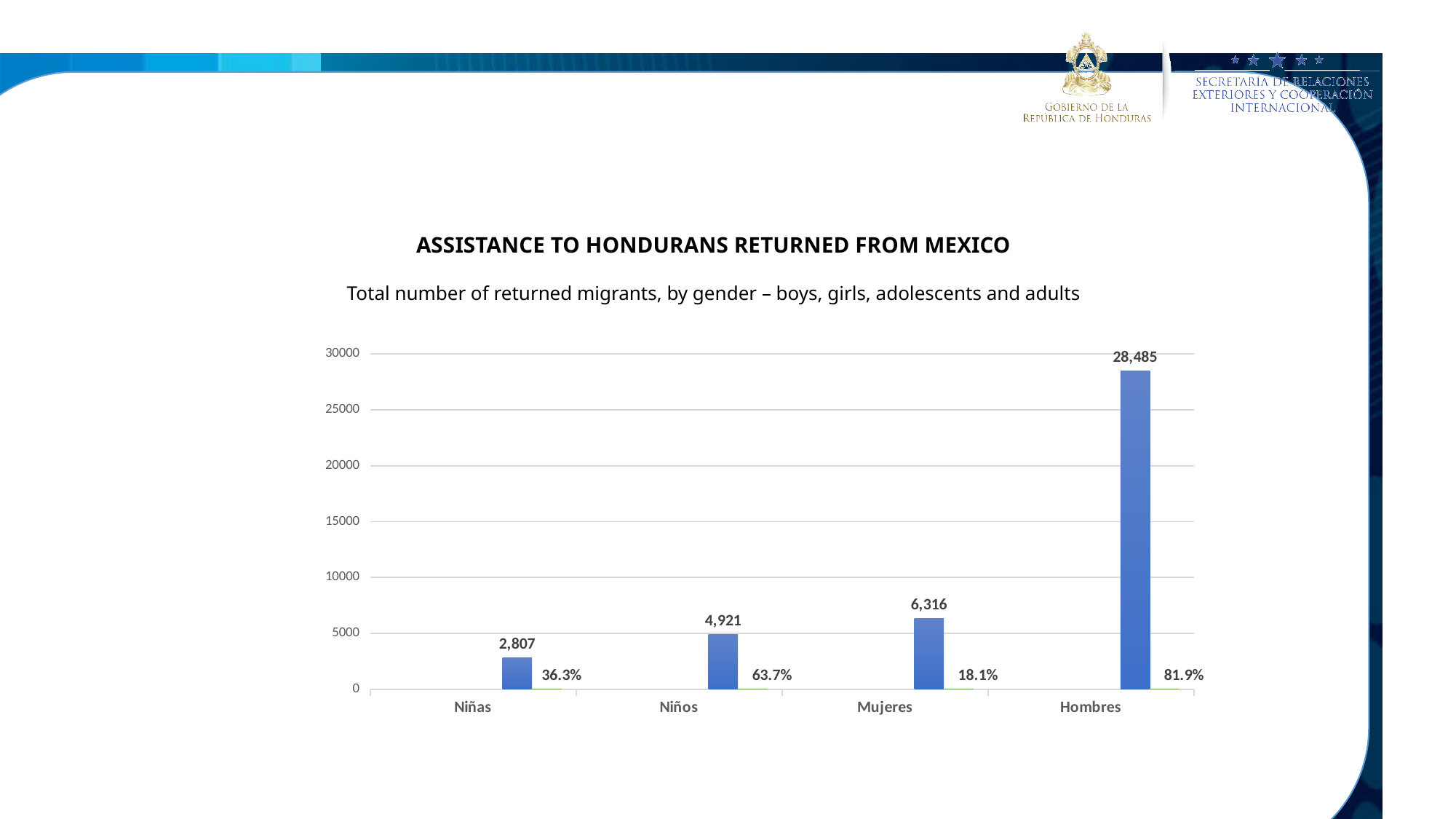
What is the title of the chart? ASSISTANCE TO HONDURANS RETURNED FROM MEXICO What is the number of returned migrants for Niñas? 2,807 Which category has the highest number of returned migrants? Hombres How many categories are shown on the x axis? 4 Is the value for Hombres greater or less than 25000? greater What is the number of returned migrants for Mujeres? 6,316 What kind of chart is shown on the slide? bar chart Which category has the lowest number of returned migrants? Niñas What is the number of returned migrants for Hombres? 28,485 What is the difference between the number of returned migrants for Niños and Niñas? 2,114 Which has more returned migrants, Mujeres or Niños? Mujeres What percentage label is shown next to the Niños bar? 63.7%